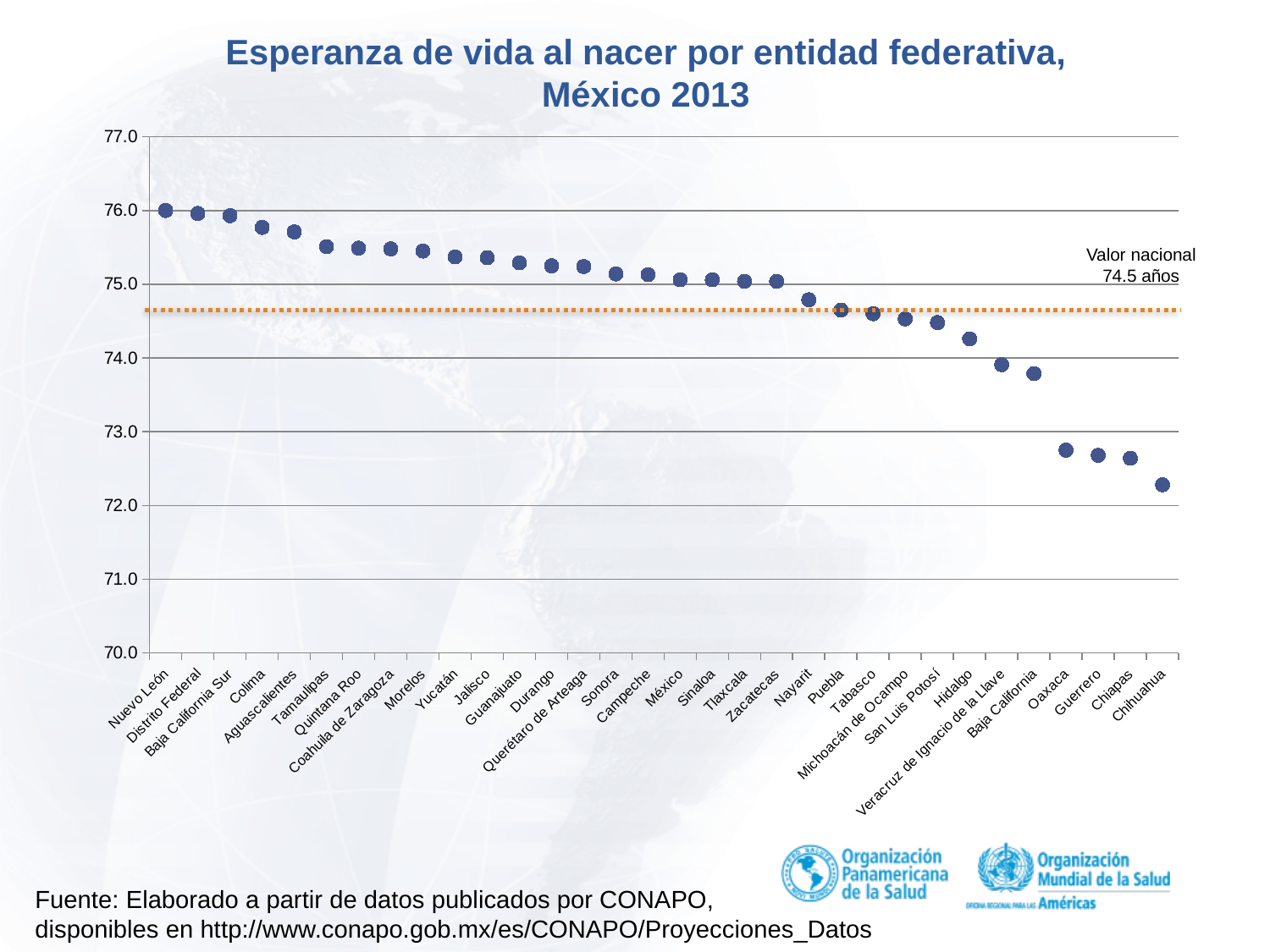
Is the value for Baja California greater or less than 74.0? less Is the value for Tabasco greater or less than 75.0? less Which entidad federativa has the lowest life expectancy at birth in the chart? Chihuahua How many entidades federativas (categories) are plotted on the x axis? 32 What is the national value (valor nacional) indicated by the dotted line? 74.5 años What is the title of the chart? Esperanza de vida al nacer por entidad federativa, México 2013 What kind of chart is shown on the slide? Scatter (dot) chart Which has a higher life expectancy at birth, Colima or Guerrero? Colima Is the value for Chihuahua greater or less than 73.0? less Do the values rise or fall moving from left to right along the x axis? fall